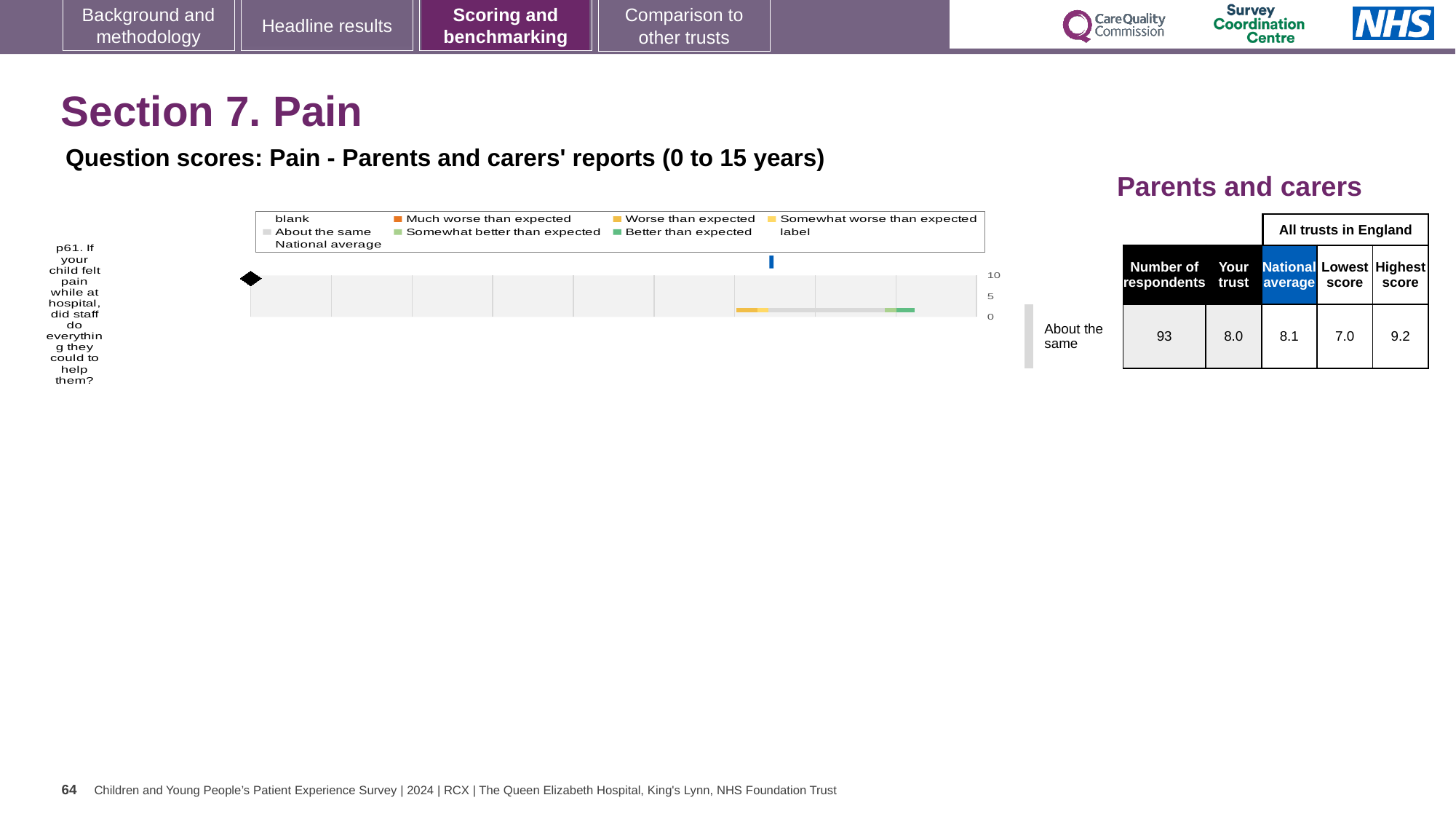
What is the lowest score among all trusts in England for question p61? 7.0 What is the national average score for question p61? 8.1 Which is larger for question p61: the 'Your trust' score or the national average? National average What kind of chart is shown on the slide for question p61? bar chart What is the difference between the highest score and the lowest score for question p61? 2.2 How many respondents answered question p61? 93 How many survey questions are plotted in the chart? 1 What is the highest score among all trusts in England for question p61? 9.2 What is the 'Your trust' score for question p61 (If your child felt pain while at hospital, did staff do everything they could to help them?)? 8.0 Which benchmarking category is question p61 assigned to? About the same By how much does the national average exceed the 'Your trust' score for question p61? 0.1 What is the highest tick value shown on the chart's score axis? 10